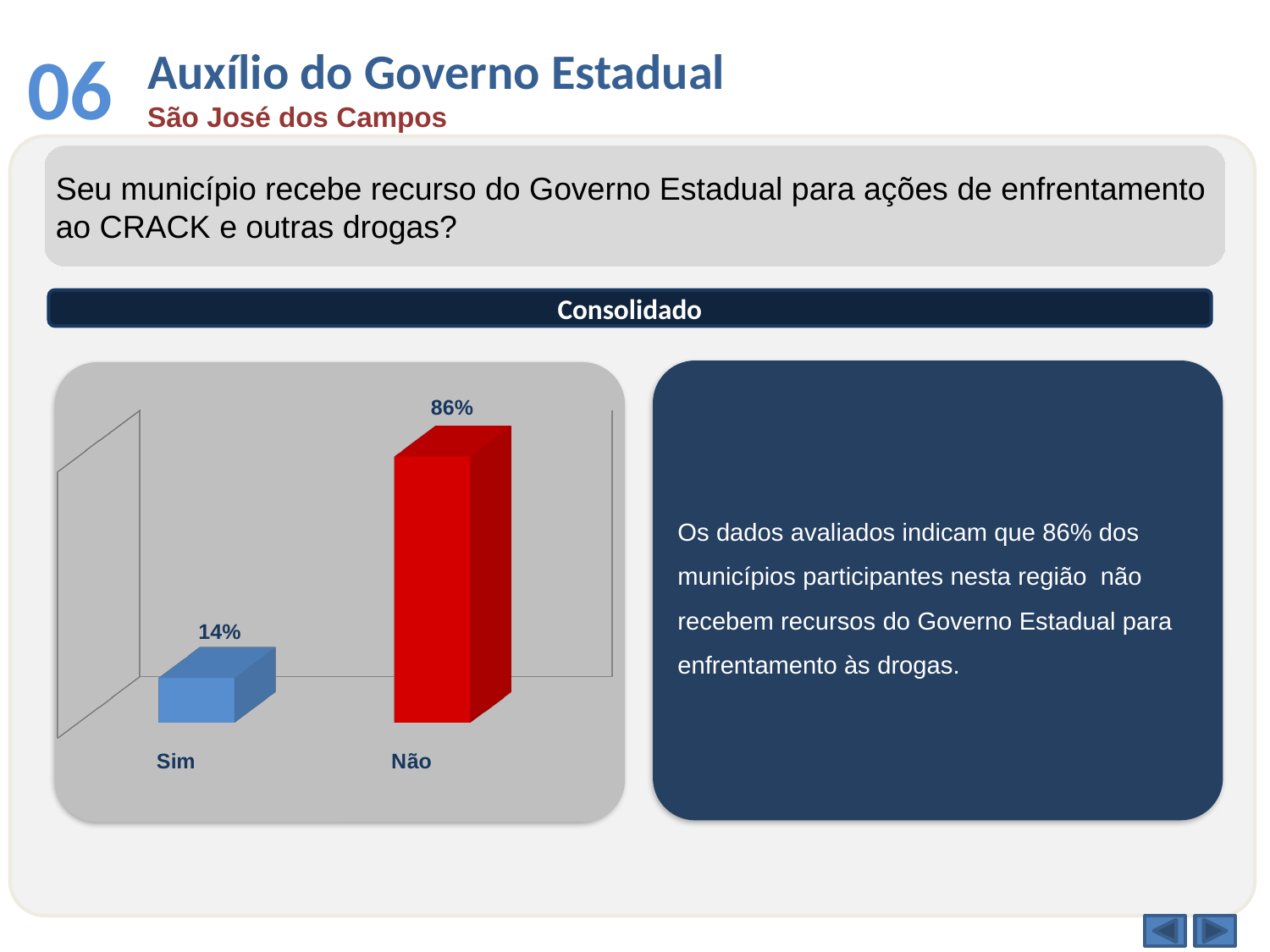
How many categories are shown in the chart? 2 What is the value for Sim? 14% What colour is the bar for Não? red Which category has the lowest value? Sim What is the total of the values for Sim and Não? 100% What is the value for Não? 86% Which category has the highest value? Não What is the difference between the values for Não and Sim? 72% What kind of chart is shown on the slide? bar chart What colour is the bar for Sim? blue Which is larger, the value for Sim or the value for Não? Não